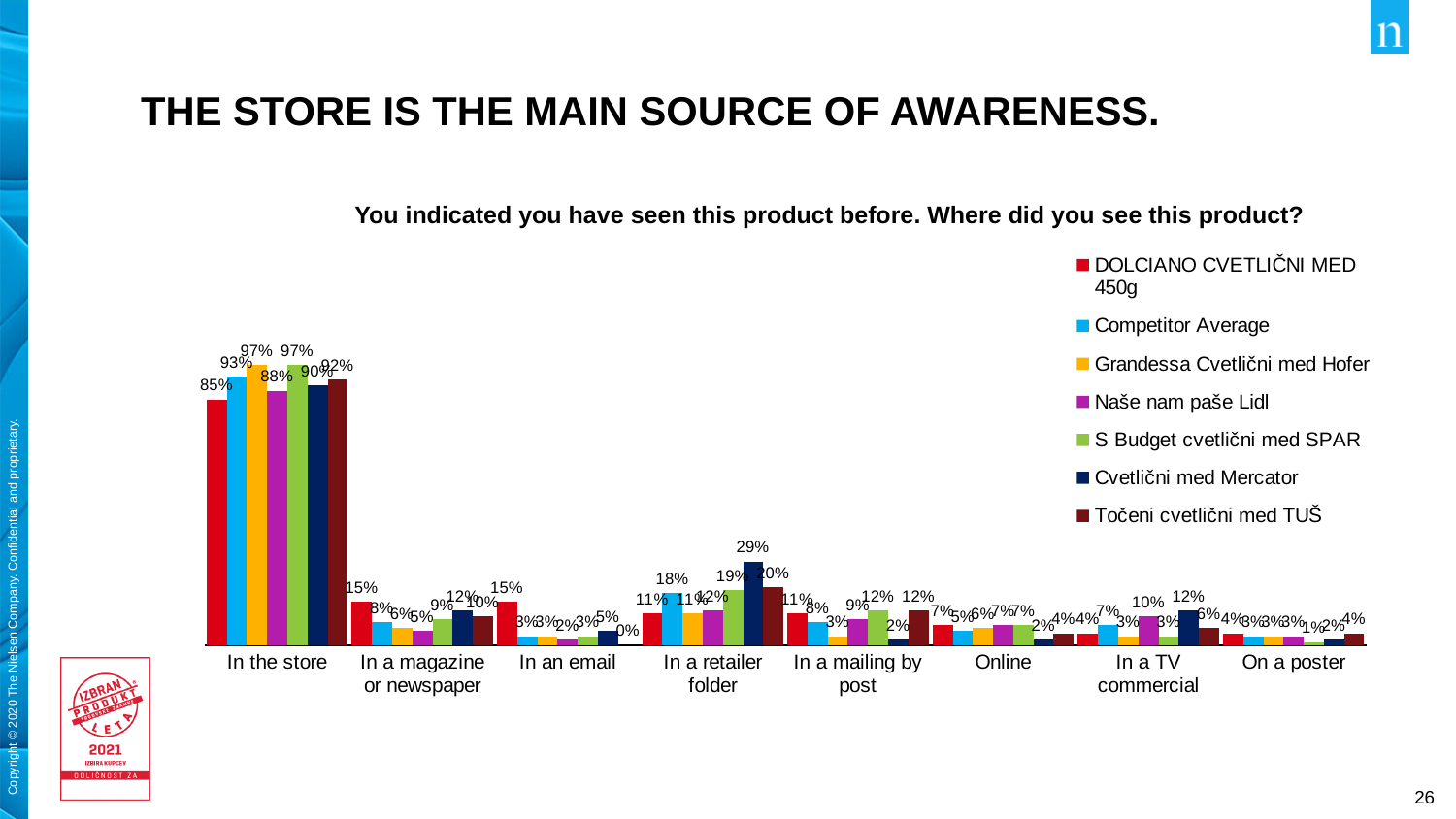
What is the value for Competitor Average in the 'In a retailer folder' category? 18% What is the value for Cvetlični med Mercator in the 'In a retailer folder' category? 29% How many series does the legend list? 7 What percentage of DOLCIANO CVETLIČNI MED 450g respondents saw the product in the store? 85% What is the value for Točeni cvetlični med TUŠ in the 'In an email' category? 0% What is the value for DOLCIANO CVETLIČNI MED 450g in the 'In a magazine or newspaper' category? 15% What is the difference between Cvetlični med Mercator and DOLCIANO CVETLIČNI MED 450g in the 'In a retailer folder' category? 18% What type of chart is shown on the slide? Bar chart Which series has the highest value in the 'In a retailer folder' category? Cvetlični med Mercator In the 'In the store' category, which is larger: DOLCIANO CVETLIČNI MED 450g or Competitor Average? Competitor Average Which series has the lowest value in the 'In the store' category? DOLCIANO CVETLIČNI MED 450g How many categories (sources of awareness) are shown on the x axis? 8